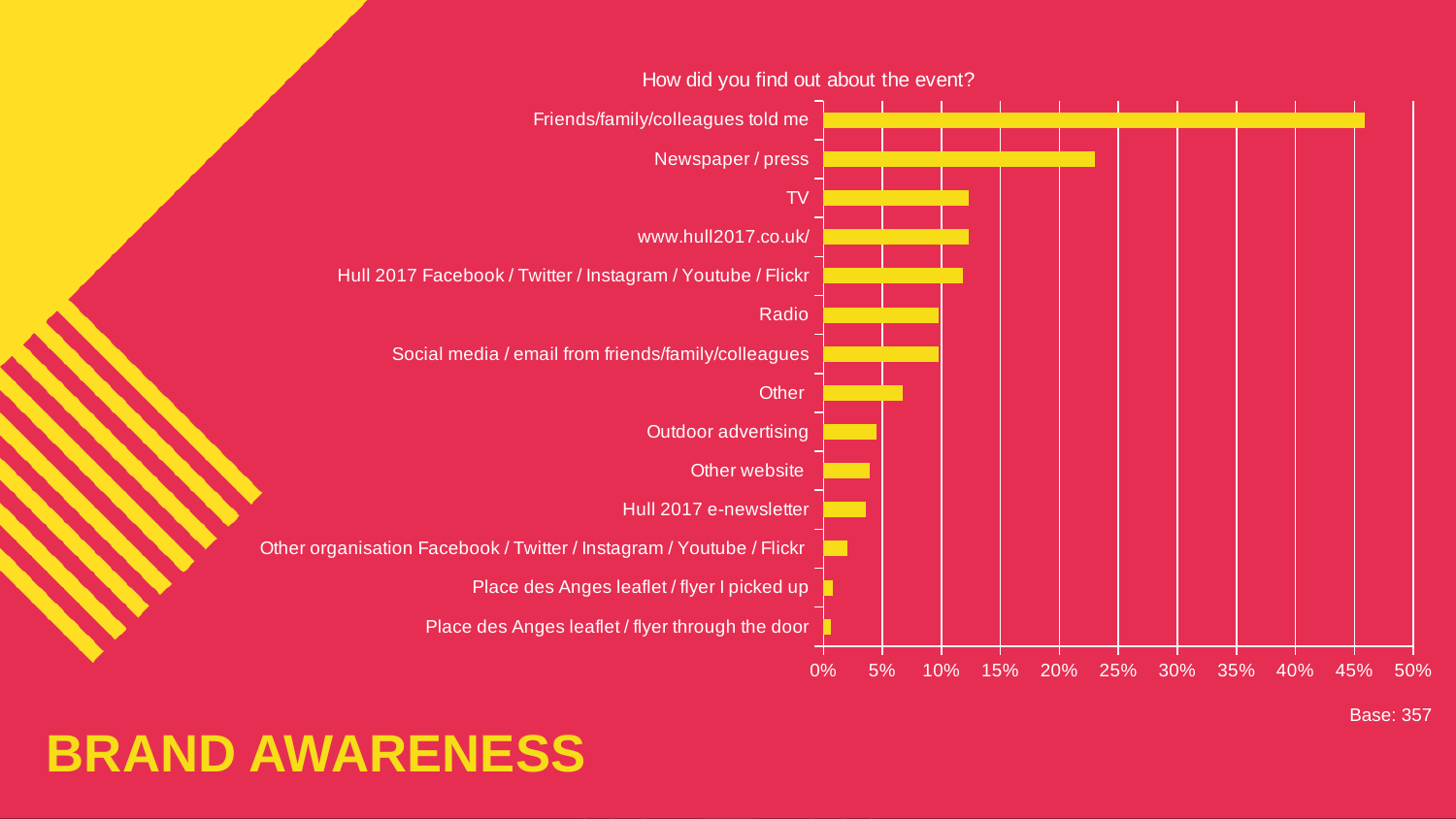
Is the value for Newspaper / press greater or less than 20%? greater What kind of chart is shown on the slide? bar chart Which category has the highest value? Friends/family/colleagues told me How many categories are plotted in the chart? 14 Is the value for Other website greater or less than 5%? less Is the value for Friends/family/colleagues told me greater or less than 40%? greater What is the title of the chart? How did you find out about the event? What base size is stated for the chart? Base: 357 Which is larger, the value for Newspaper / press or the value for TV? Newspaper / press Which is larger, the value for Other or the value for Outdoor advertising? Other